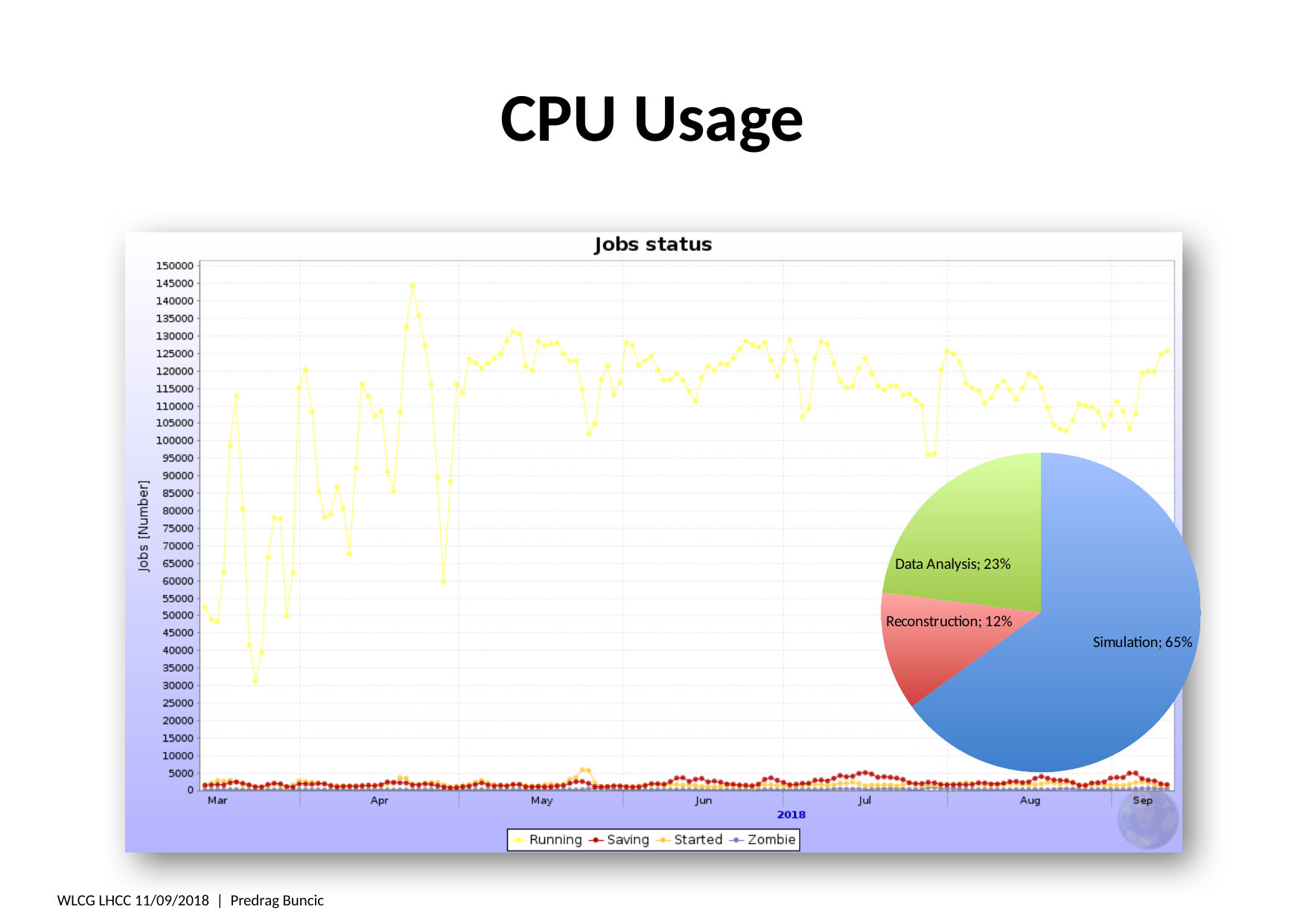
In the pie chart on the right, what share does Simulation have? 65% What is the y-axis label of the 'Jobs status' chart? Jobs [Number] In the pie chart on the right, which category has the smallest slice? Reconstruction In the 'Jobs status' chart, is the peak value of the Running series greater or less than 130000? greater In the pie chart on the right, what share does Data Analysis have? 23% What kind of chart is the 'Jobs status' chart? Line chart In the pie chart on the right, what share does Reconstruction have? 12% In the pie chart on the right, how many percentage points larger is Simulation than Data Analysis? 42 In the pie chart on the right, how many slices are there? 3 How many series does the legend of the 'Jobs status' chart list? 4 In the 'Jobs status' chart, which series has the highest values throughout the period? Running In the pie chart on the right, which category has the largest slice? Simulation